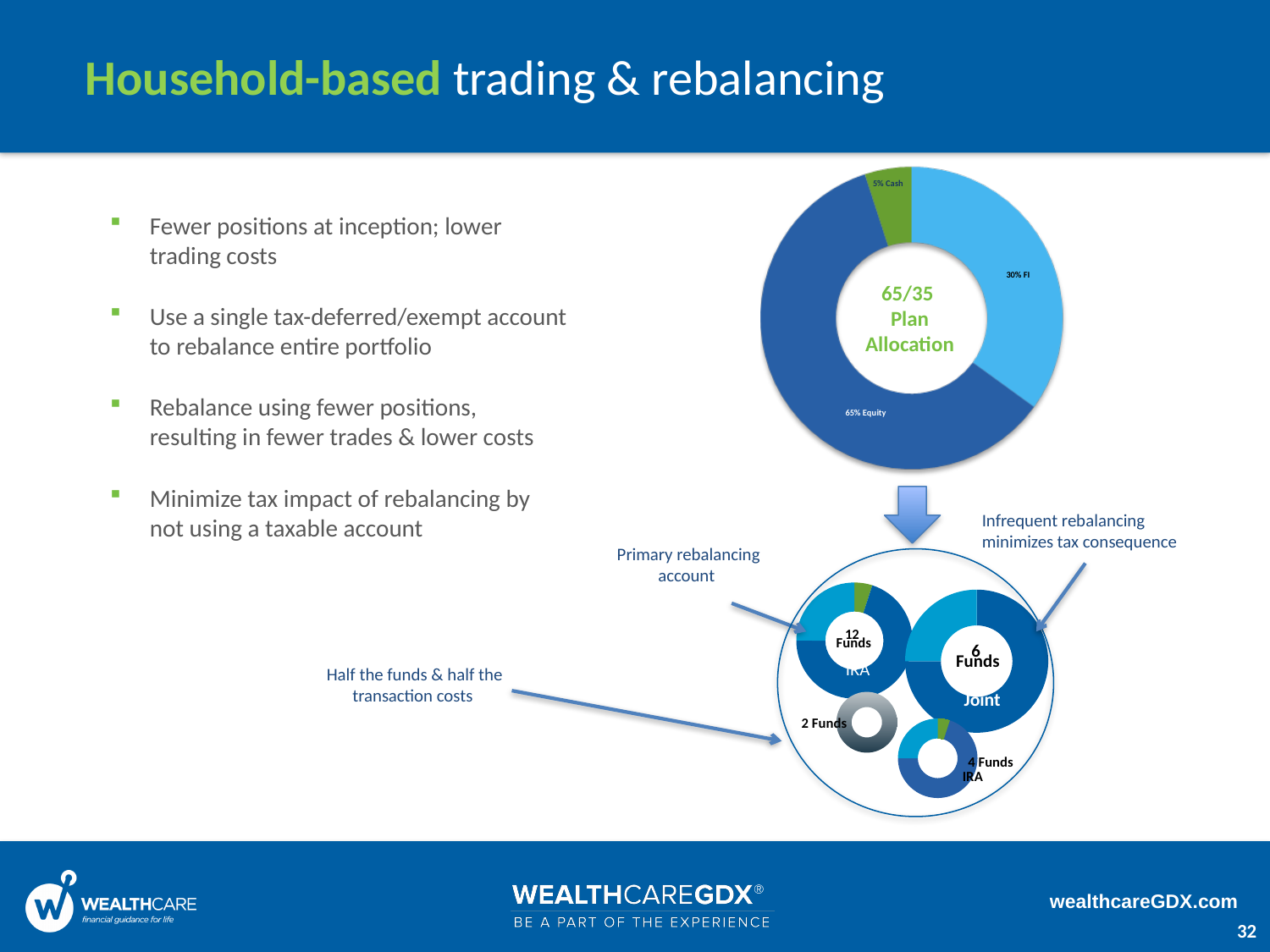
In the 65/35 Plan Allocation donut chart, which is larger, the FI share or the Cash share? FI What text is shown in the center of the large donut chart? 65/35 Plan Allocation In the 65/35 Plan Allocation donut chart, what do the Equity, FI and Cash shares add up to? 100% In the small donut charts at the bottom right, how many funds are shown for the Joint account? 6 Funds In the 65/35 Plan Allocation donut chart, what percentage is allocated to Equity? 65% How many slices does the 65/35 Plan Allocation donut chart have? 3 In the 65/35 Plan Allocation donut chart, what percentage is allocated to FI? 30% In the 65/35 Plan Allocation donut chart, how much larger is the Equity share than the FI share? 35% In the 65/35 Plan Allocation donut chart, which category has the largest share? Equity What kind of chart is the large chart at the top right of the slide? Donut (pie) chart In the 65/35 Plan Allocation donut chart, what percentage is allocated to Cash? 5% In the 65/35 Plan Allocation donut chart, which category has the smallest share? Cash